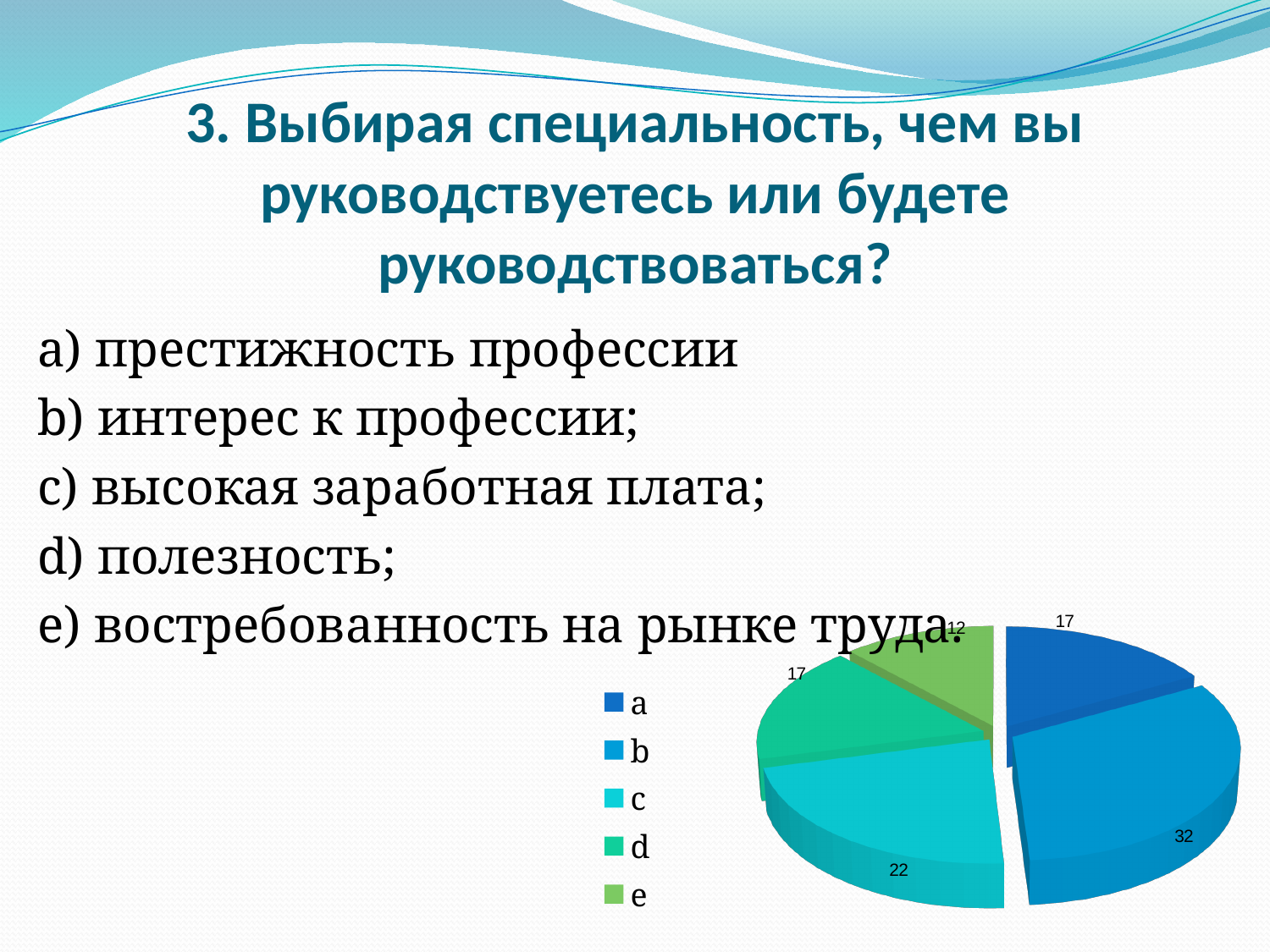
What is the value of slice b in the pie chart? 32 How many entries does the legend of the pie chart list? 5 What type of chart is shown on the slide? pie chart Which is larger in the pie chart, slice c or slice e? c What is the value of slice e in the pie chart? 12 What is the value of slice c in the pie chart? 22 Which slice of the pie chart has the largest value? b What is the total of all slice values in the pie chart? 100 What share of the pie does slice b represent? 32% How many slices does the pie chart have? 5 Which slice of the pie chart has the smallest value? e What is the difference between the values of slices b and c in the pie chart? 10